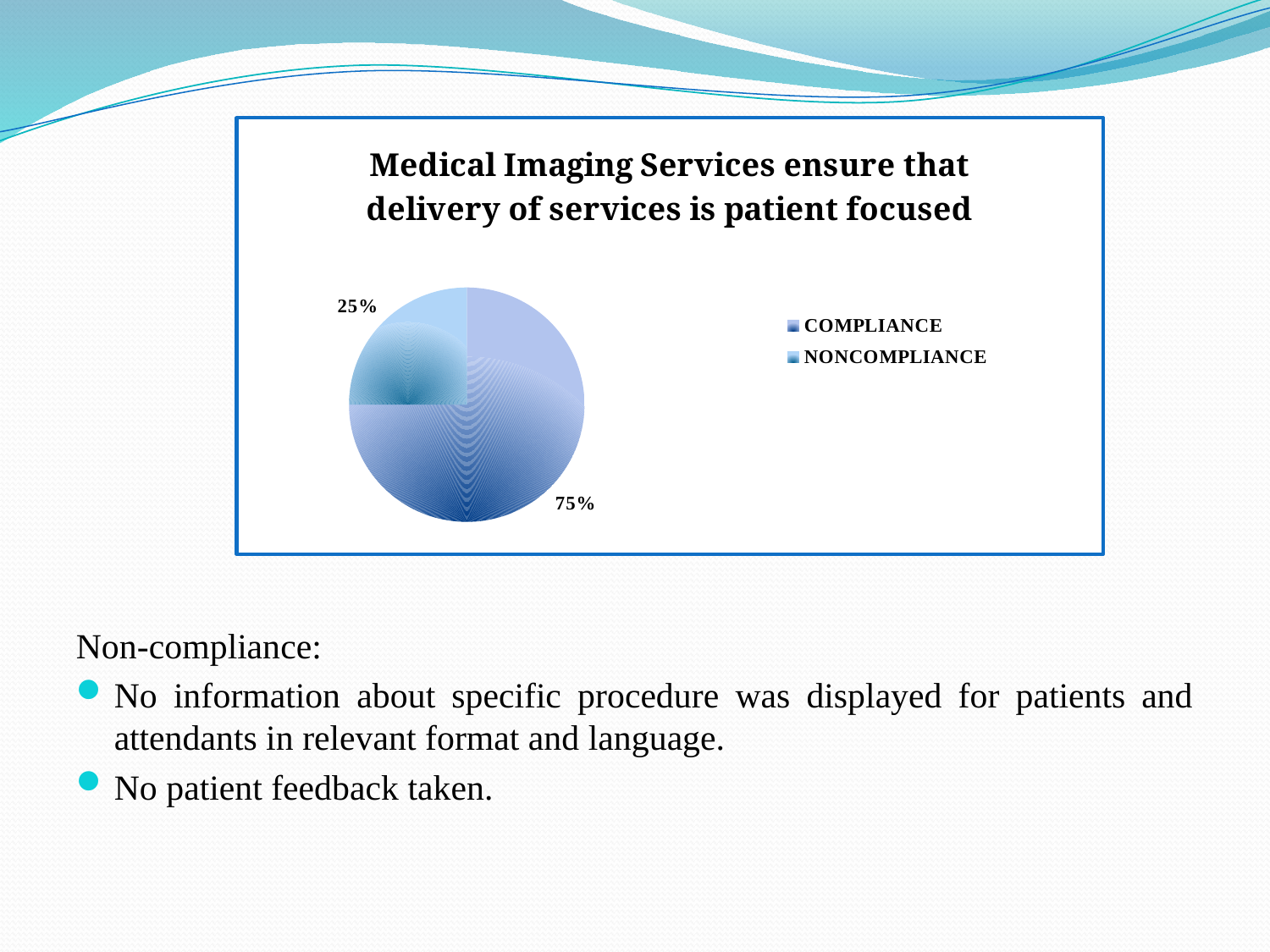
Which legend entry is listed first? COMPLIANCE What is the value for NONCOMPLIANCE? 25% What is the difference between the COMPLIANCE and NONCOMPLIANCE values? 50% What type of chart is shown on the slide? Pie chart What is the title of the chart? Medical Imaging Services ensure that delivery of services is patient focused Which category has the smallest share of the pie? NONCOMPLIANCE What is the value for COMPLIANCE? 75% How many categories does the pie chart show? 2 Which category has the largest share of the pie? COMPLIANCE Which is larger, COMPLIANCE or NONCOMPLIANCE? COMPLIANCE What share of the pie does the COMPLIANCE slice represent? 75% How many entries does the legend list? 2